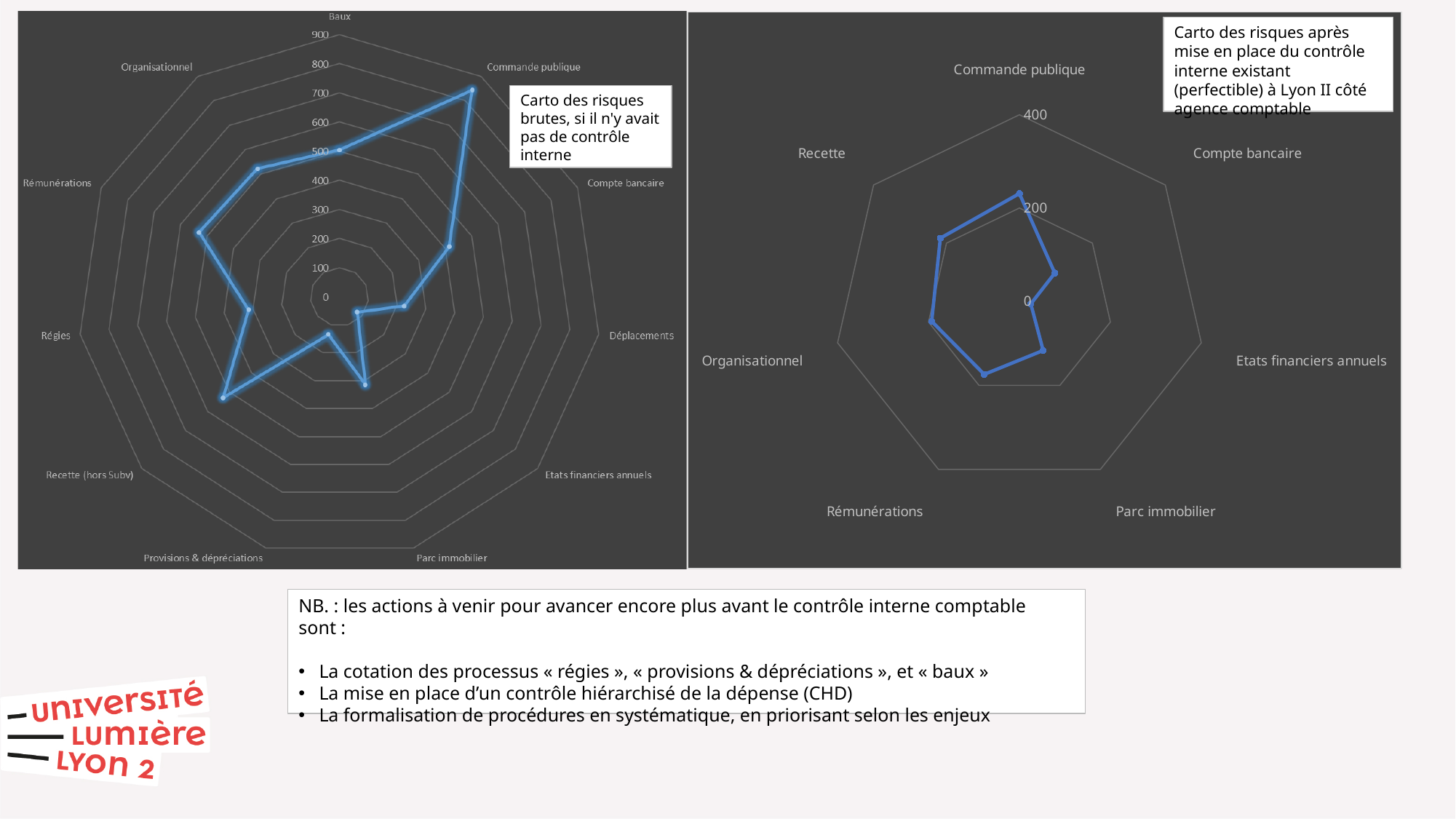
On the left chart (Carto des risques brutes), which category has the highest value? Commande publique What is the maximum value shown on the axis of the left chart (Carto des risques brutes)? 900 What is the maximum value shown on the axis of the right chart (Carto des risques après mise en place du contrôle interne)? 400 On the left chart (Carto des risques brutes), is the value for Recette (hors Subv) greater or less than 400? greater On the right chart (Carto des risques après mise en place du contrôle interne), is the value for Etats financiers annuels greater or less than 200? less On the left chart (Carto des risques brutes), which is larger, the value for Commande publique or the value for Déplacements? Commande publique What kind of chart is the left chart (Carto des risques brutes)? radar chart On the left chart (Carto des risques brutes), is the value for Etats financiers annuels greater or less than 200? less How many categories are plotted on the left chart (Carto des risques brutes)? 11 How many categories are plotted on the right chart (Carto des risques après mise en place du contrôle interne)? 7 On the right chart (Carto des risques après mise en place du contrôle interne), which category has the highest value? Commande publique